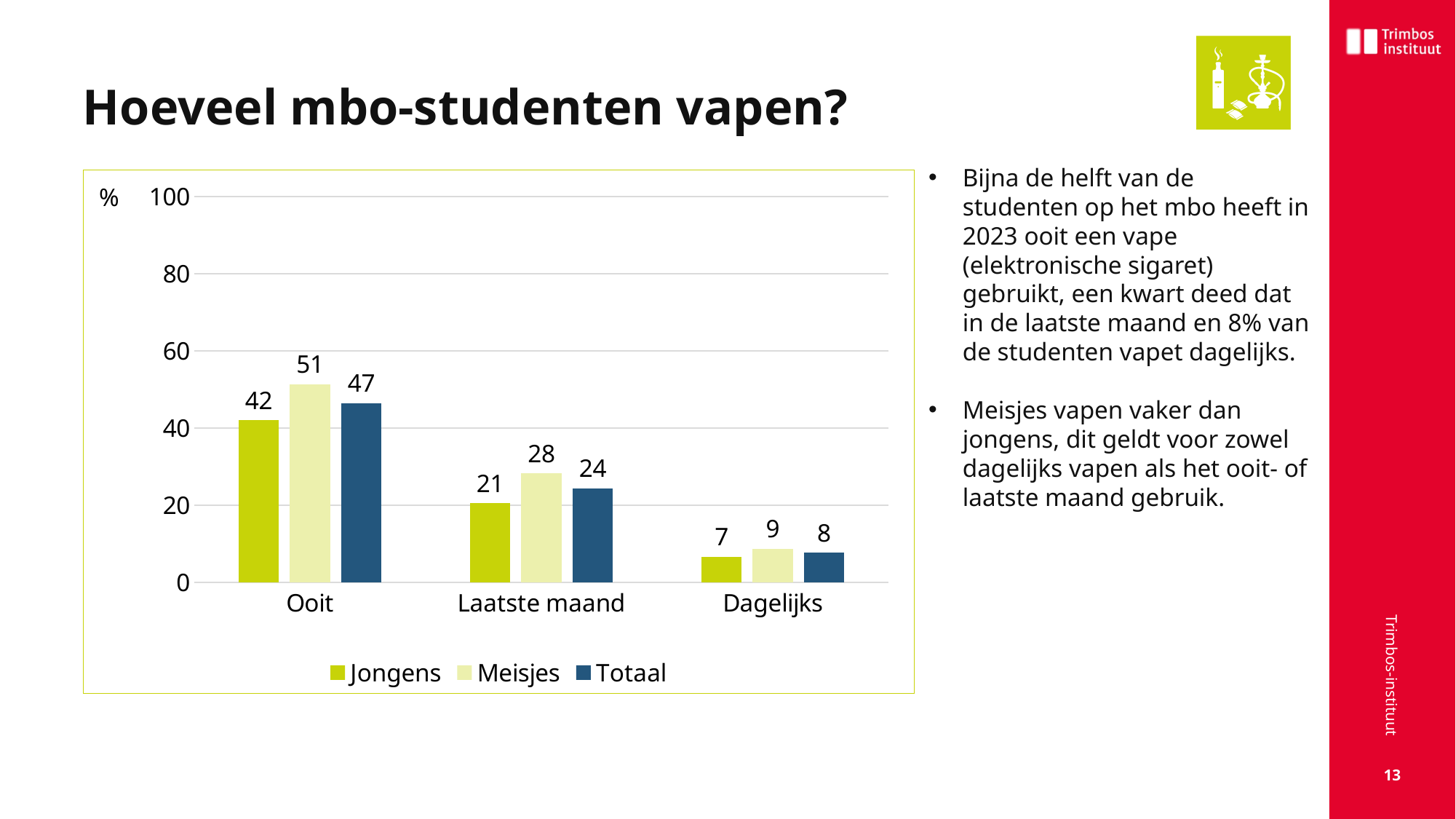
How many categories are shown on the x axis? 3 What is the value for Meisjes in the Ooit category? 51 What is the value for Totaal in the Dagelijks category? 8 Which category has the lowest value for Jongens? Dagelijks Which category has the highest value for Totaal? Ooit Is the value for Totaal in the Ooit category greater or less than 40? greater What is the value for Jongens in the Laatste maand category? 21 What is the difference between the Meisjes and Jongens values in the Ooit category? 9 How many series does the legend list? 3 Which is larger in the Laatste maand category: Meisjes or Totaal? Meisjes Do the Jongens values rise or fall from Ooit to Dagelijks? Fall What kind of chart is shown on the slide? Bar chart